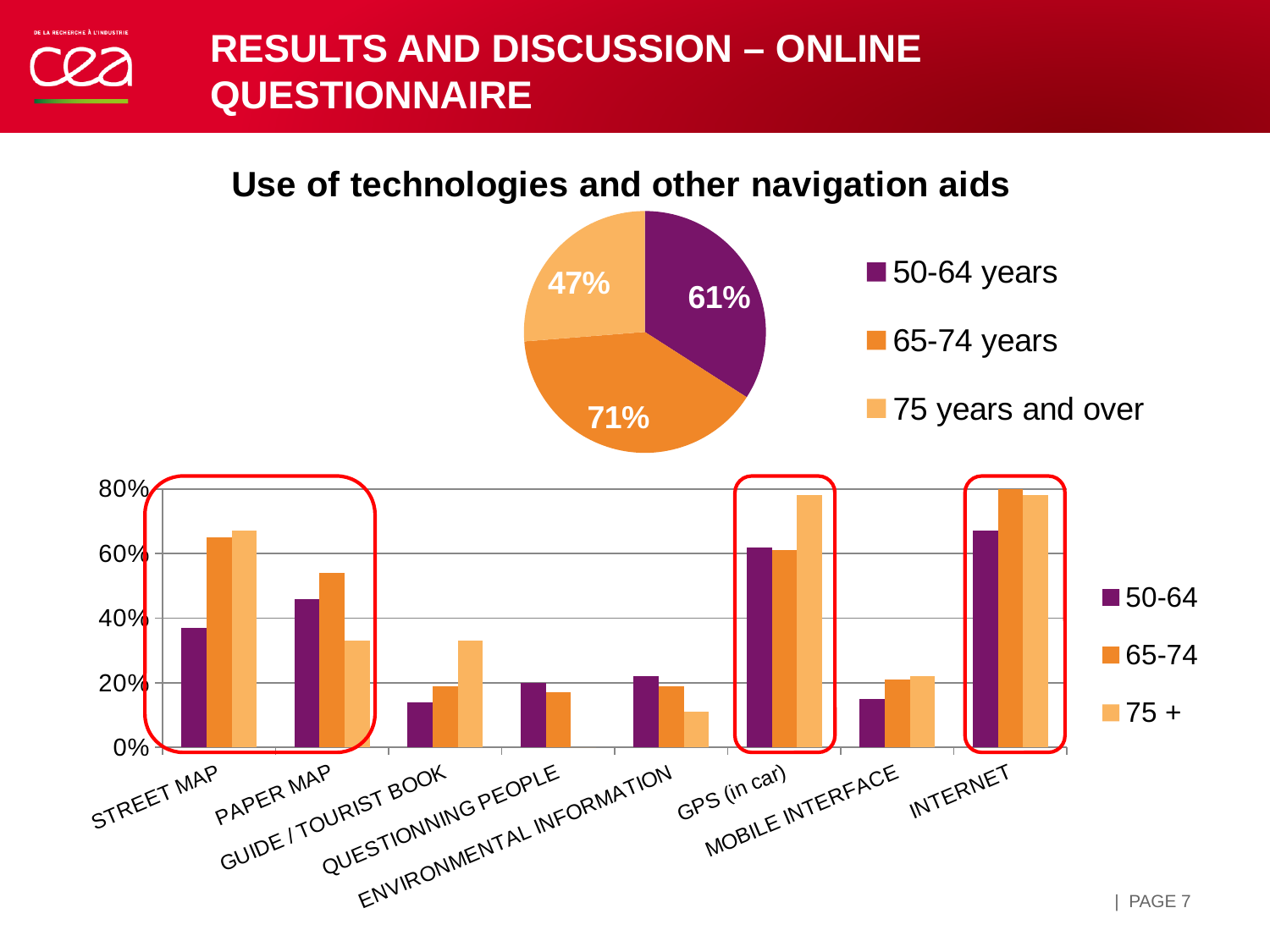
On the bar chart at the bottom, is the value for GPS (in car) in the 75 + series greater or less than 60%? greater What kind of chart is the lower chart on the slide? Bar chart On the bar chart at the bottom, is the value for STREET MAP in the 50-64 series greater or less than 40%? less On the bar chart at the bottom, how many categories are shown on the x axis? 8 On the bar chart at the bottom, which series has the highest value for PAPER MAP? 65-74 On the bar chart at the bottom, for STREET MAP, which is larger: the 65-74 value or the 50-64 value? 65-74 On the pie chart, which age group has the lowest percentage? 75 years and over On the pie chart, which age group has the highest percentage? 65-74 years On the pie chart, what percentage is shown for the 65-74 years group? 71% On the pie chart, what is the difference between the 65-74 years value and the 50-64 years value? 10% On the bar chart at the bottom, how many series does the legend list? 3 On the pie chart, what percentage is shown for the 75 years and over group? 47%